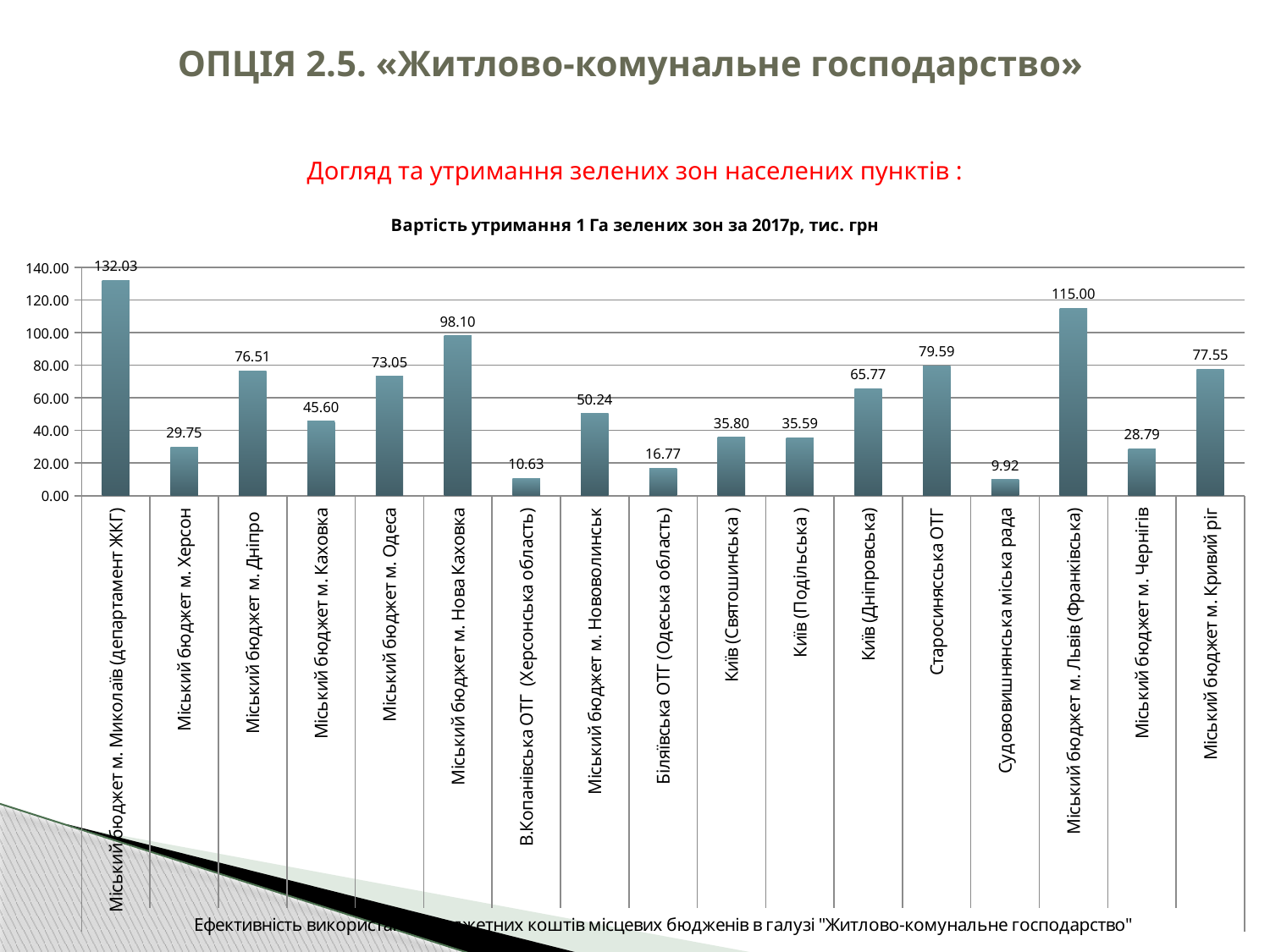
How many categories are shown in the chart? 17 What kind of chart is shown on the slide? bar chart What is the value for Міський бюджет м. Чернігів? 28.79 What is the title of the chart? Вартість утримання 1 Га зелених зон за 2017р, тис. грн Which category has the lowest value? Судововишнянська міська рада Which category has the highest value? Міський бюджет м. Миколаїв (департамент ЖКГ) What is the value for Старосинясська ОТГ? 79.59 What is the value for Київ (Дніпровська)? 65.77 Is the value for Міський бюджет м. Каховка greater or less than 40.00? greater What is the value for Міський бюджет м. Нова Каховка? 98.10 What is the difference between the values for Міський бюджет м. Миколаїв (департамент ЖКГ) and Міський бюджет м. Львів (Франківська)? 17.03 Which is larger, the value for Міський бюджет м. Одеса or for Міський бюджет м. Нова Каховка? Міський бюджет м. Нова Каховка